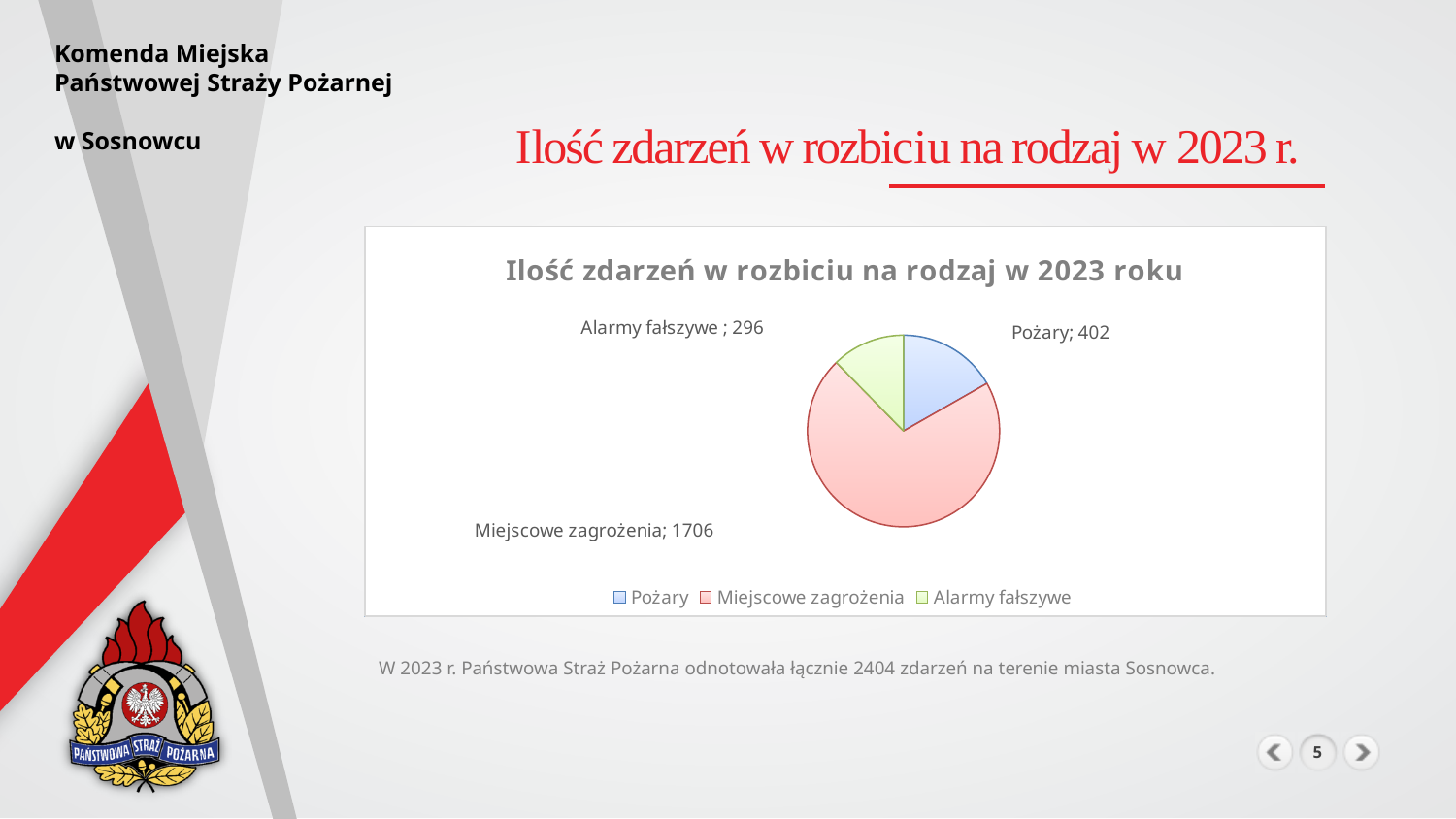
What is the value for Alarmy fałszywe in the pie chart? 296 What is the difference between the values for Miejscowe zagrożenia and Pożary? 1304 How many entries does the legend of the pie chart list? 3 What is the value for Pożary in the pie chart? 402 Which is larger, the value for Pożary or the value for Alarmy fałszywe? Pożary How many slices does the pie chart have? 3 Which category has the smallest slice in the pie chart? Alarmy fałszywe What is the value for Miejscowe zagrożenia in the pie chart? 1706 What is the total of all three slices in the pie chart? 2404 What kind of chart is shown on the slide? pie chart What is the title of the chart? Ilość zdarzeń w rozbiciu na rodzaj w 2023 roku Which category has the largest slice in the pie chart? Miejscowe zagrożenia